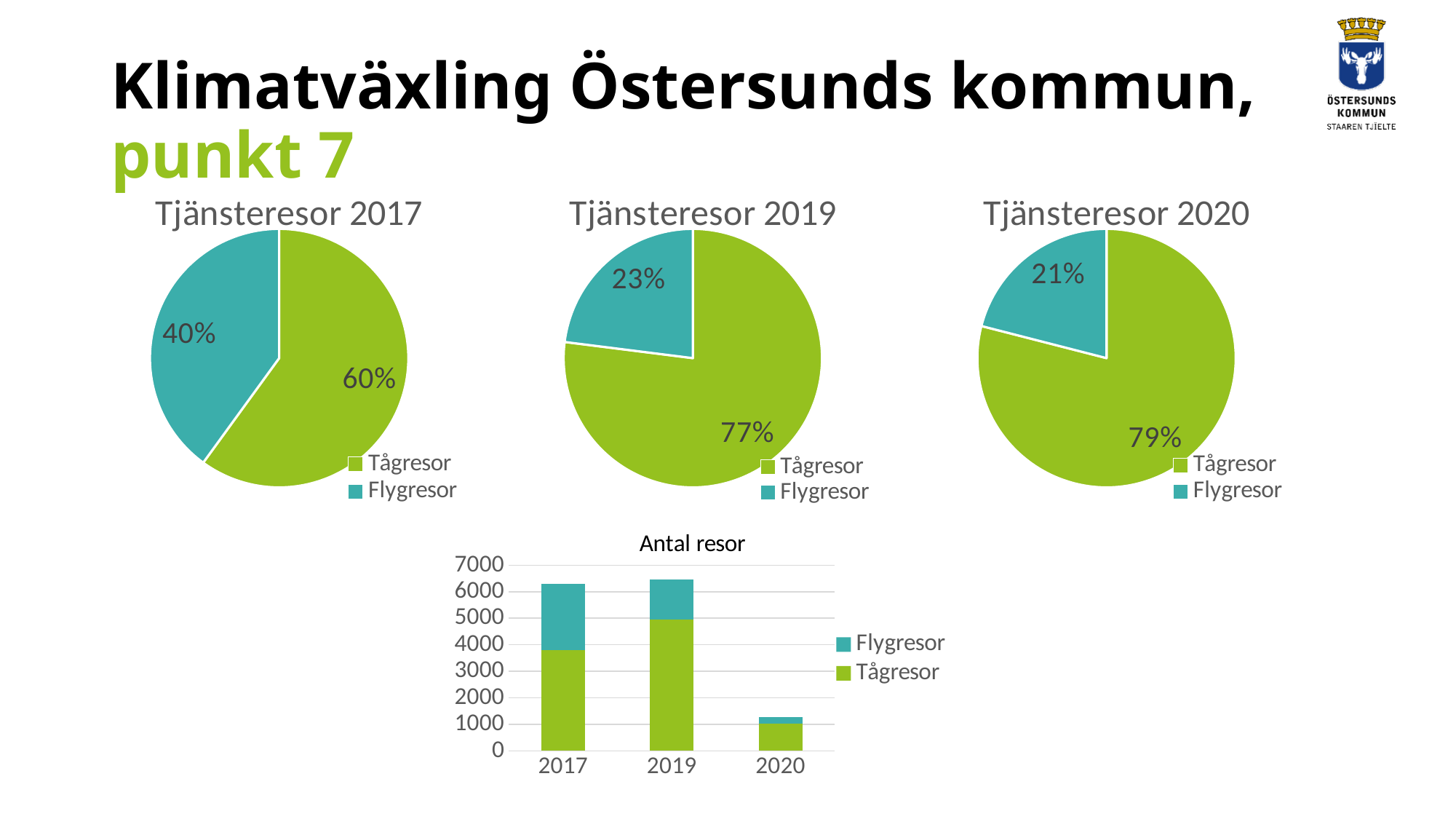
In the Antal resor chart, is the total for 2020 greater or less than 2000? less In the Tjänsteresor 2020 pie chart, what share is Tågresor? 79% In the Antal resor chart, is the value for Tågresor in 2017 greater or less than 3000? greater How many years are shown on the x axis of the Antal resor chart? 3 In the Antal resor chart, which year has the lowest total number of trips? 2020 In the Tjänsteresor 2019 pie chart, which slice is larger, Tågresor or Flygresor? Tågresor In the Tjänsteresor 2019 pie chart, what share is Flygresor? 23% In the Tjänsteresor 2017 pie chart, what is the difference in percentage points between Tågresor and Flygresor? 20 How many series does the legend of the Antal resor chart list? 2 In the Tjänsteresor 2020 pie chart, which slice is the smallest? Flygresor In the Tjänsteresor 2017 pie chart, what share is Tågresor? 60% What kind of chart is the Antal resor chart? Stacked bar chart